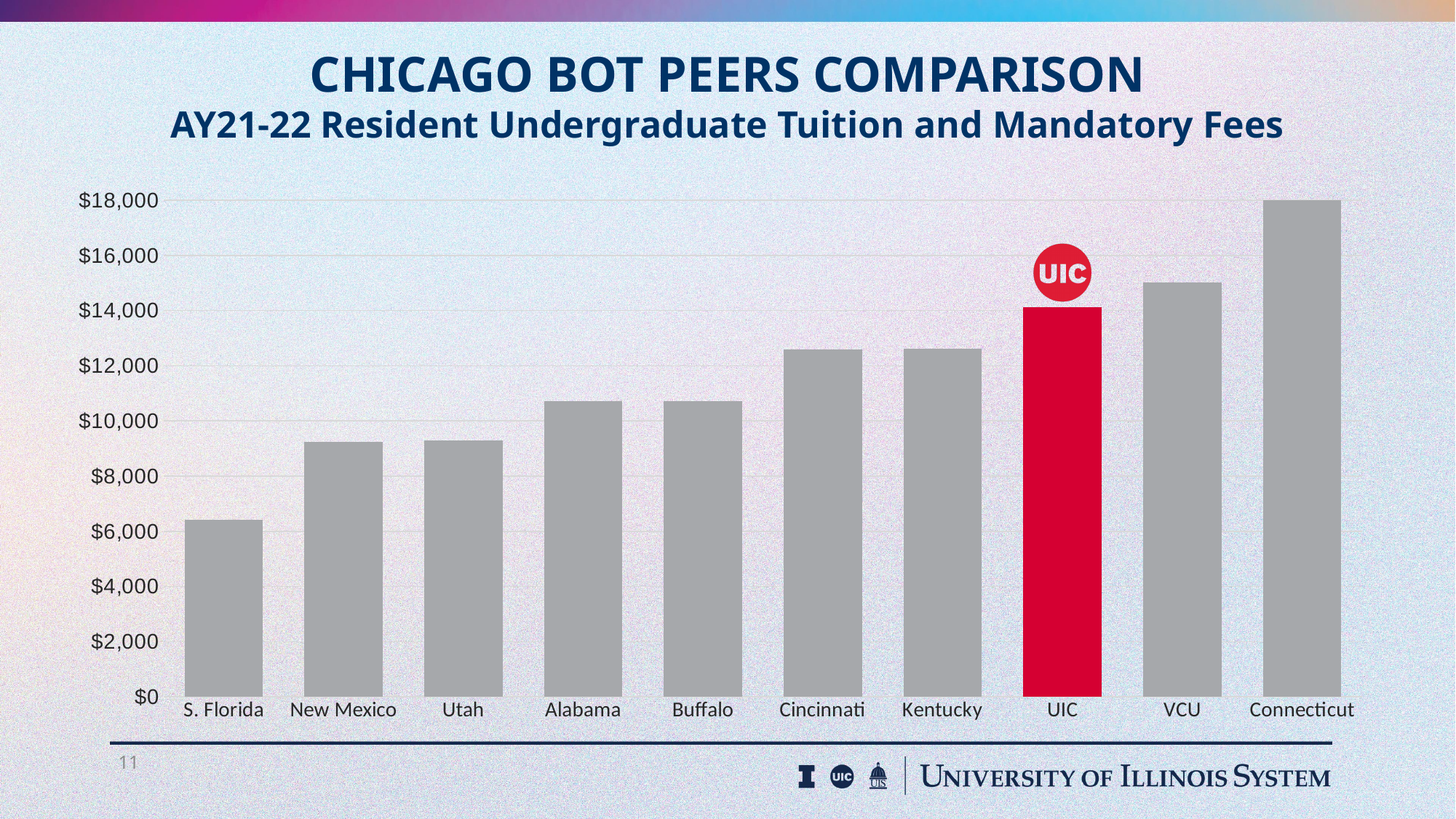
Is the value for UIC greater or less than $12,000? greater What kind of chart is shown on the slide? bar chart Which institution has the highest resident undergraduate tuition and mandatory fees in the chart? Connecticut Which institution has the lowest resident undergraduate tuition and mandatory fees in the chart? S. Florida Is the value for VCU greater or less than $14,000? greater Is the value for S. Florida greater or less than $8,000? less Which is larger, the value for UIC or the value for Kentucky? UIC Do the values generally rise or fall moving from left to right along the x axis? rise How many institutions are shown on the x axis of the chart? 10 Which institution's bar is coloured red in the chart? UIC